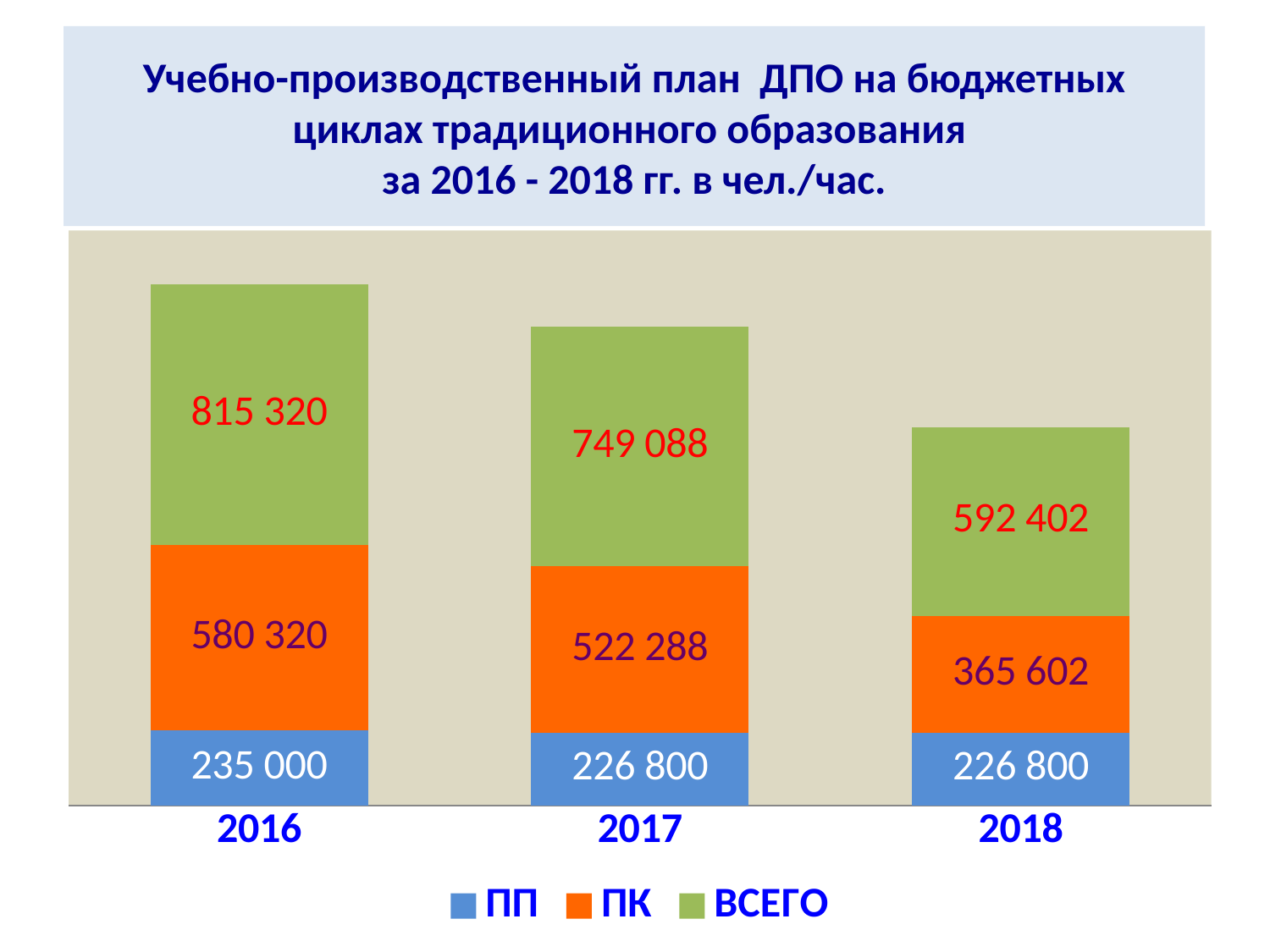
What is the value of the ВСЕГО series for 2018? 592 402 What is the difference between the ВСЕГО values for 2016 and 2017? 66 232 What is the value of the ПП series for 2017? 226 800 Which is larger, the ПП value for 2016 or the ПП value for 2018? 2016 How many years are shown on the x axis? 3 What is the difference between the ПК values for 2017 and 2018? 156 686 In which year is the ПК value the lowest? 2018 What is the value of the ПК series for 2016? 580 320 What type of chart is shown on the slide? stacked bar chart How many series does the legend list? 3 What is the value of the ВСЕГО series for 2017? 749 088 In which year is the ВСЕГО value the highest? 2016